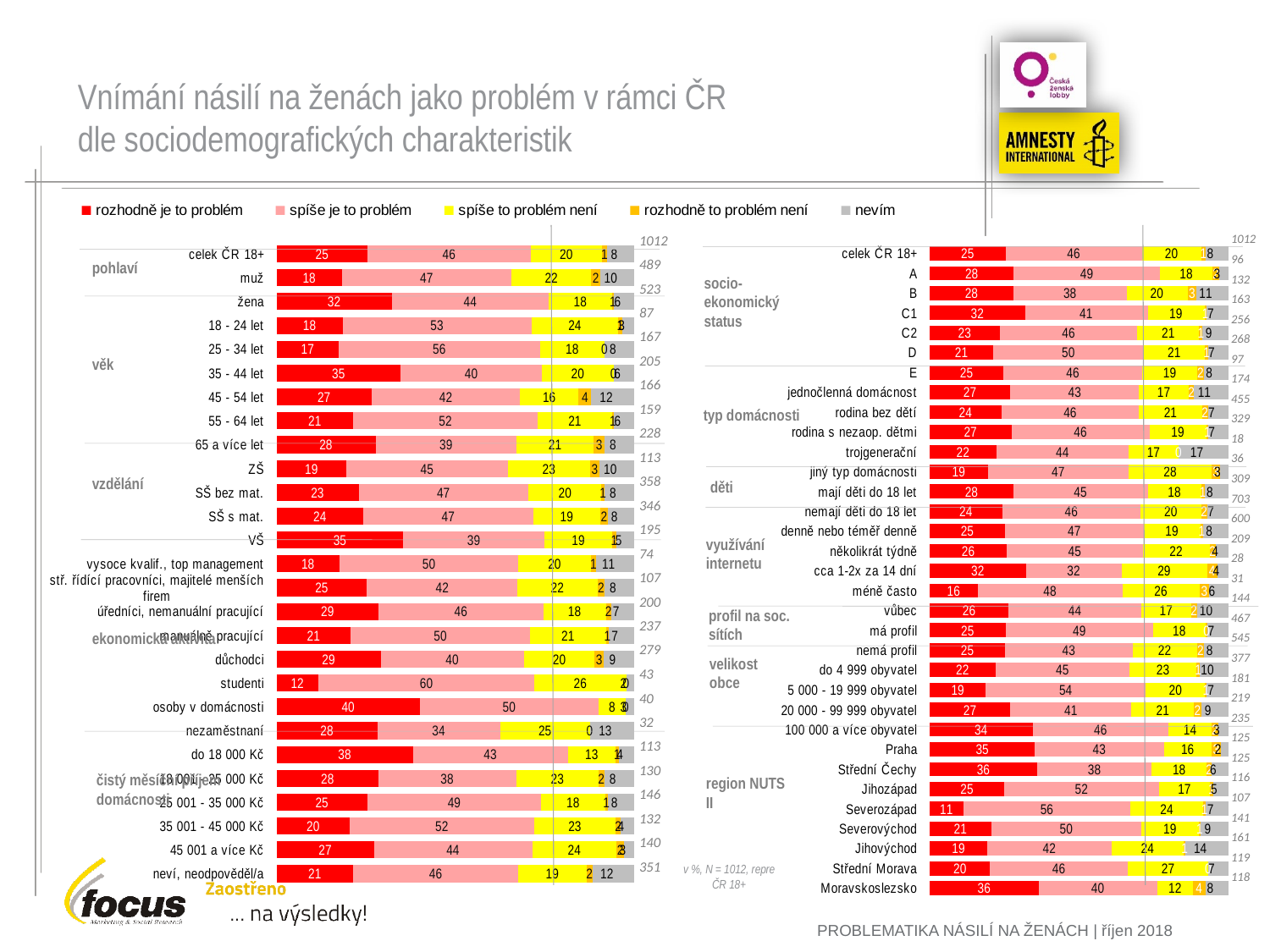
In the left chart, what is the value of 'nevím' for 'nezaměstnaní'? 13 In the left chart, what is the value of 'rozhodně je to problém' for 'žena'? 32 In the left chart, what is the value of 'spíše je to problém' for 'studenti'? 60 What kind of chart is used on this slide? stacked bar chart In the right chart, what is the value of 'nevím' for 'jednočlenná domácnost'? 11 In the left chart, which has the larger value for 'rozhodně je to problém', 'muž' or 'žena'? žena How many series does the legend list? 5 In the right chart, which NUTS II region has the lowest value for 'rozhodně je to problém'? Severozápad In the left chart, what is the difference between '25 - 34 let' and '35 - 44 let' for 'spíše je to problém'? 16 In the right chart, what is the value of 'rozhodně je to problém' for 'Moravskoslezsko'? 36 In the right chart, what is the value of 'spíše je to problém' for 'Severozápad'? 56 In the left chart, what is the difference between 'žena' and 'muž' for 'rozhodně je to problém'? 14